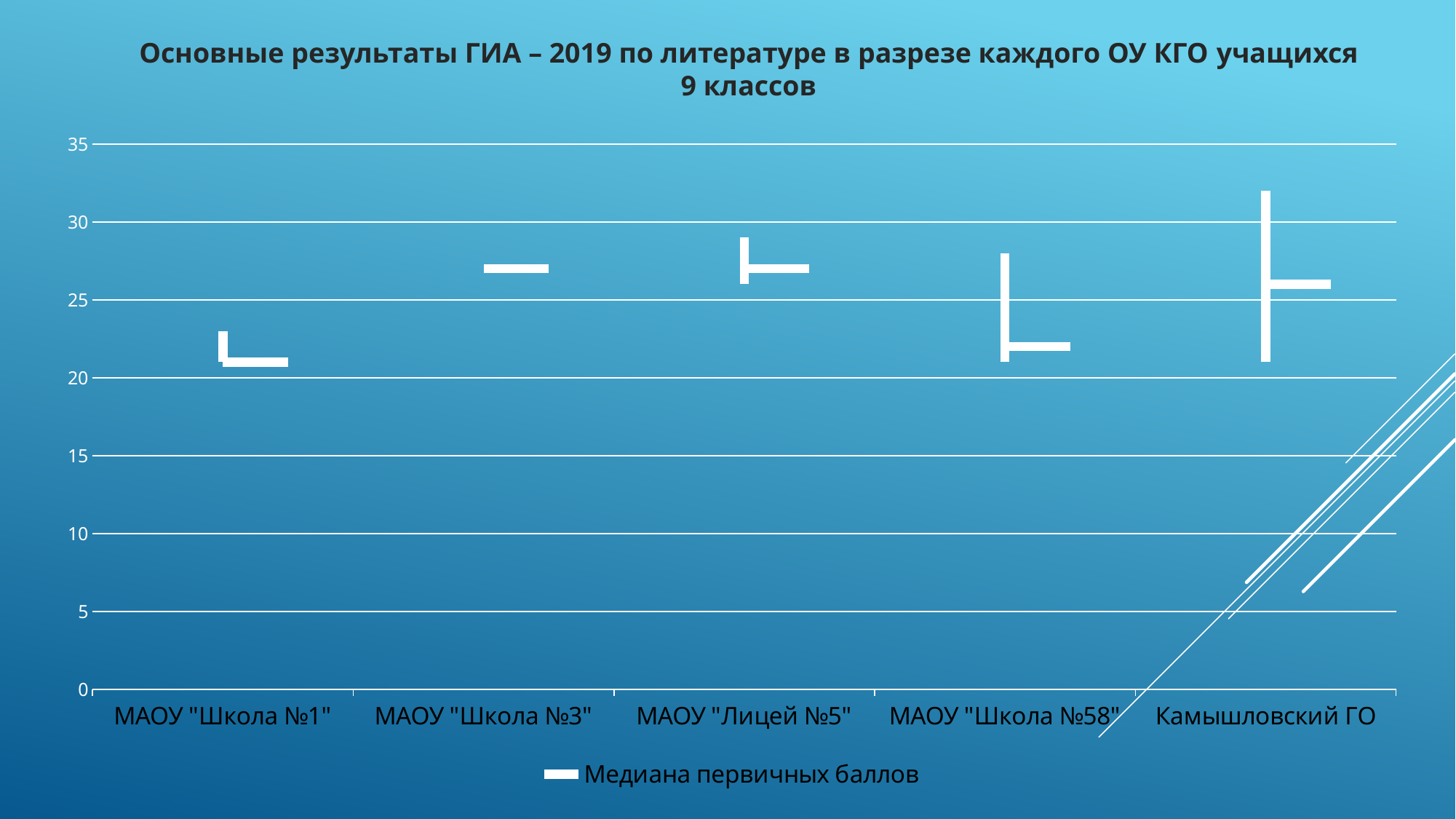
Is the median value for Камышловский ГО greater or less than 30? less Is the median value for МАОУ "Школа №1" greater or less than 20? greater Which has the higher median value: МАОУ "Школа №3" or МАОУ "Школа №1"? МАОУ "Школа №3" How many schools/categories are shown on the x axis of the chart? 5 Is the median value for МАОУ "Лицей №5" greater or less than 30? less How many series does the chart legend list? 1 What is the legend entry shown below the chart? Медиана первичных баллов What is the title of the chart? Основные результаты ГИА – 2019 по литературе в разрезе каждого ОУ КГО учащихся 9 классов Which has the higher median value: МАОУ "Лицей №5" or МАОУ "Школа №58"? МАОУ "Лицей №5"